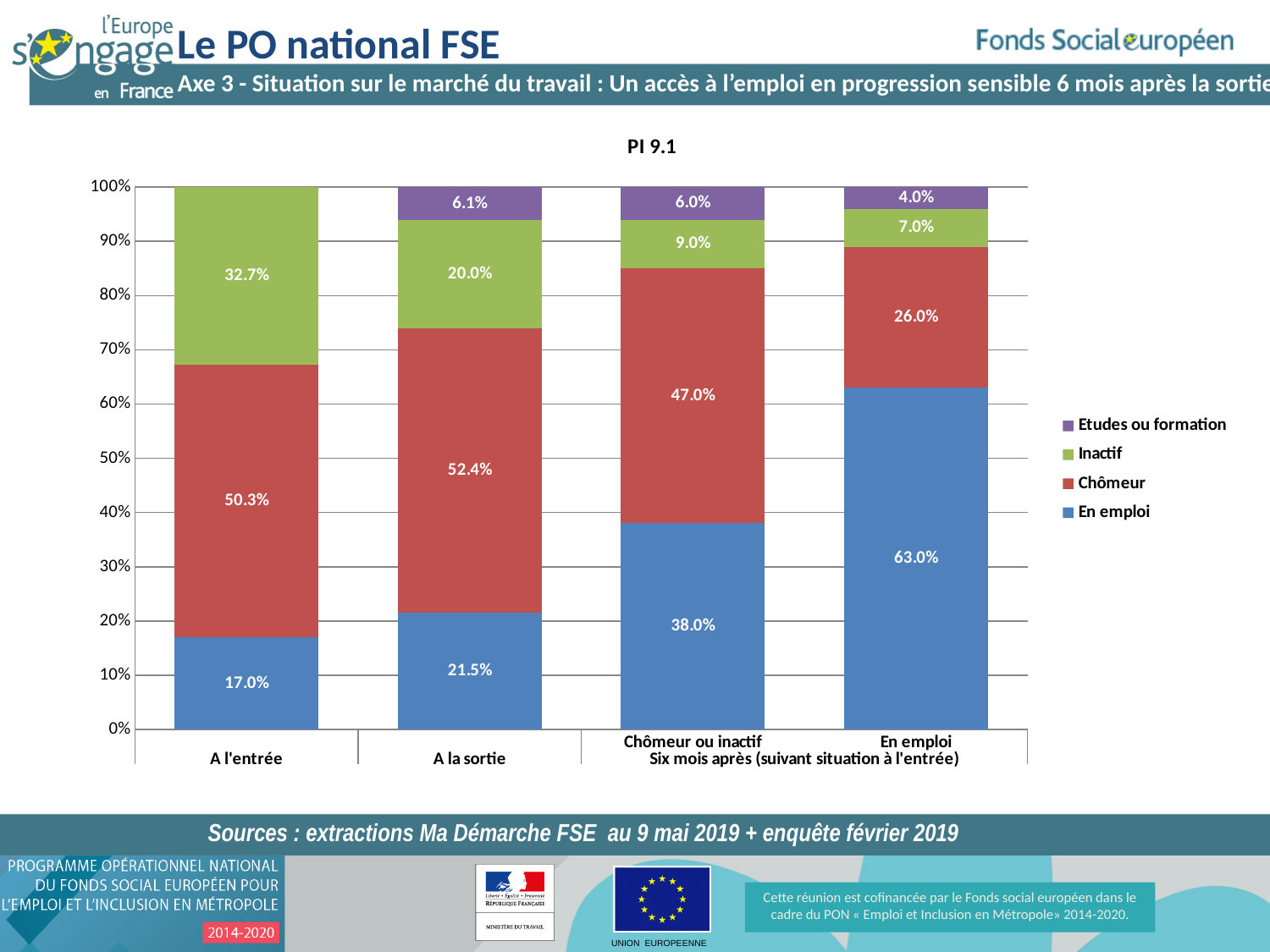
What is the value of 'Etudes ou formation' for the 'En emploi' bar (six mois après)? 4.0% What is the value of 'Inactif' for the 'A l'entrée' bar? 32.7% What is the value of 'En emploi' for the 'A l'entrée' bar? 17.0% Which bar has the lowest 'En emploi' value? A l'entrée What is the title of the chart? PI 9.1 Which is larger: the 'Chômeur' value for 'Chômeur ou inactif' or for 'En emploi' (six mois après)? Chômeur ou inactif How many series does the legend list? 4 What type of chart is shown on the slide? Stacked bar chart What is the difference between the 'En emploi' values for 'A la sortie' and 'A l'entrée'? 4.5% Which bar has the highest 'En emploi' value? En emploi (Six mois après) What is the value of 'Chômeur' for the 'A la sortie' bar? 52.4% Does the 'En emploi' value rise or fall from 'A l'entrée' to 'A la sortie'? Rise